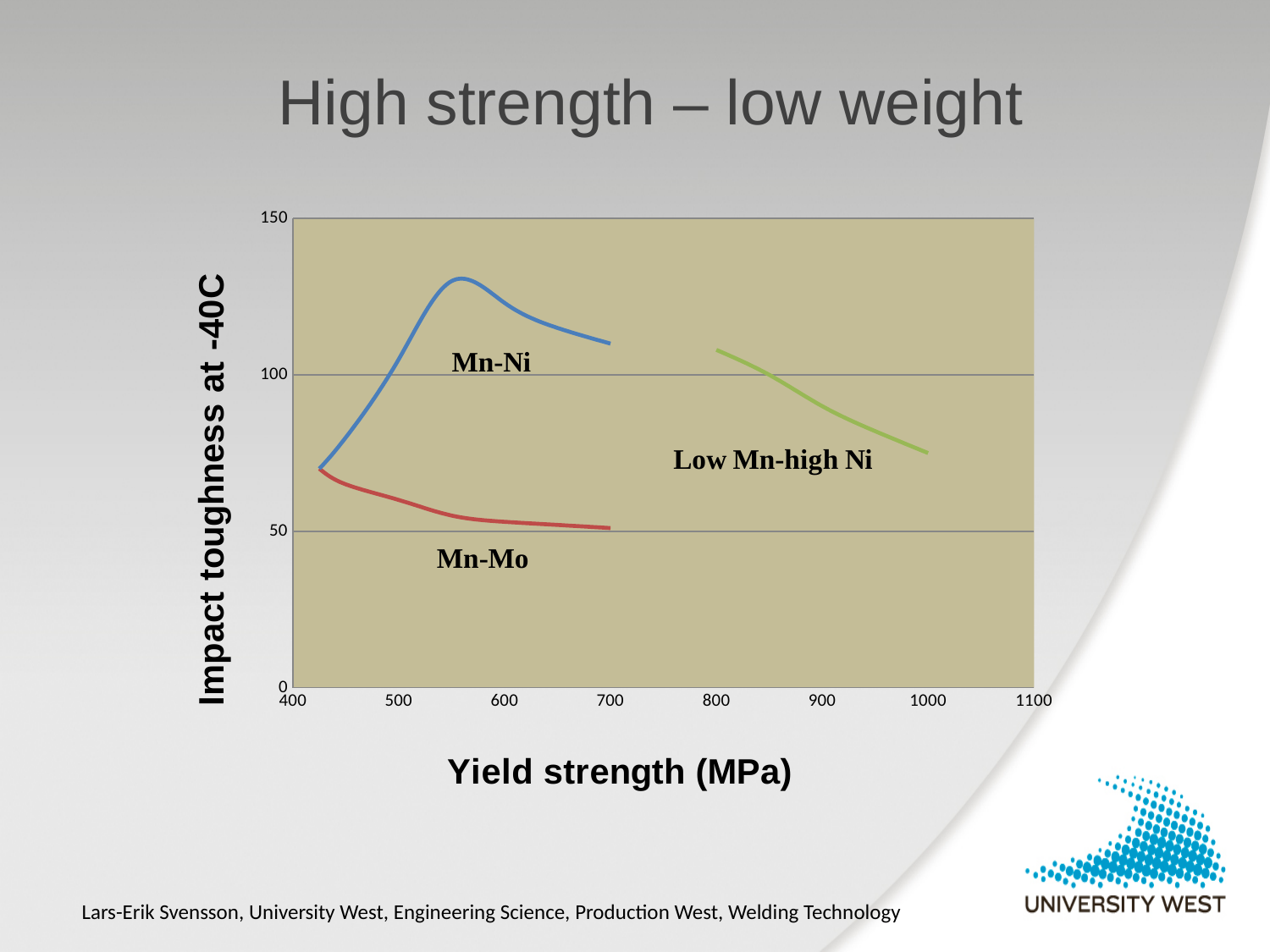
Is the impact toughness of the Low Mn-high Ni curve at 1000 MPa greater or less than 100? less What is the label of the x axis? Yield strength (MPa) Does the impact toughness of the Mn-Mo curve rise or fall as yield strength increases? fall Which curve has the lowest impact toughness values? Mn-Mo What kind of chart is shown on the slide? line chart Is the peak impact toughness of the Mn-Ni curve greater or less than 100? greater Which curve reaches the highest impact toughness? Mn-Ni Is the impact toughness of the Mn-Mo curve at 500 MPa greater or less than 50? greater How many curves are plotted on the chart? 3 What is the label of the y axis? Impact toughness at -40C Does the impact toughness of the Low Mn-high Ni curve rise or fall as yield strength increases from 800 to 1000 MPa? fall At a yield strength of 600 MPa, which curve has the higher impact toughness, Mn-Ni or Mn-Mo? Mn-Ni